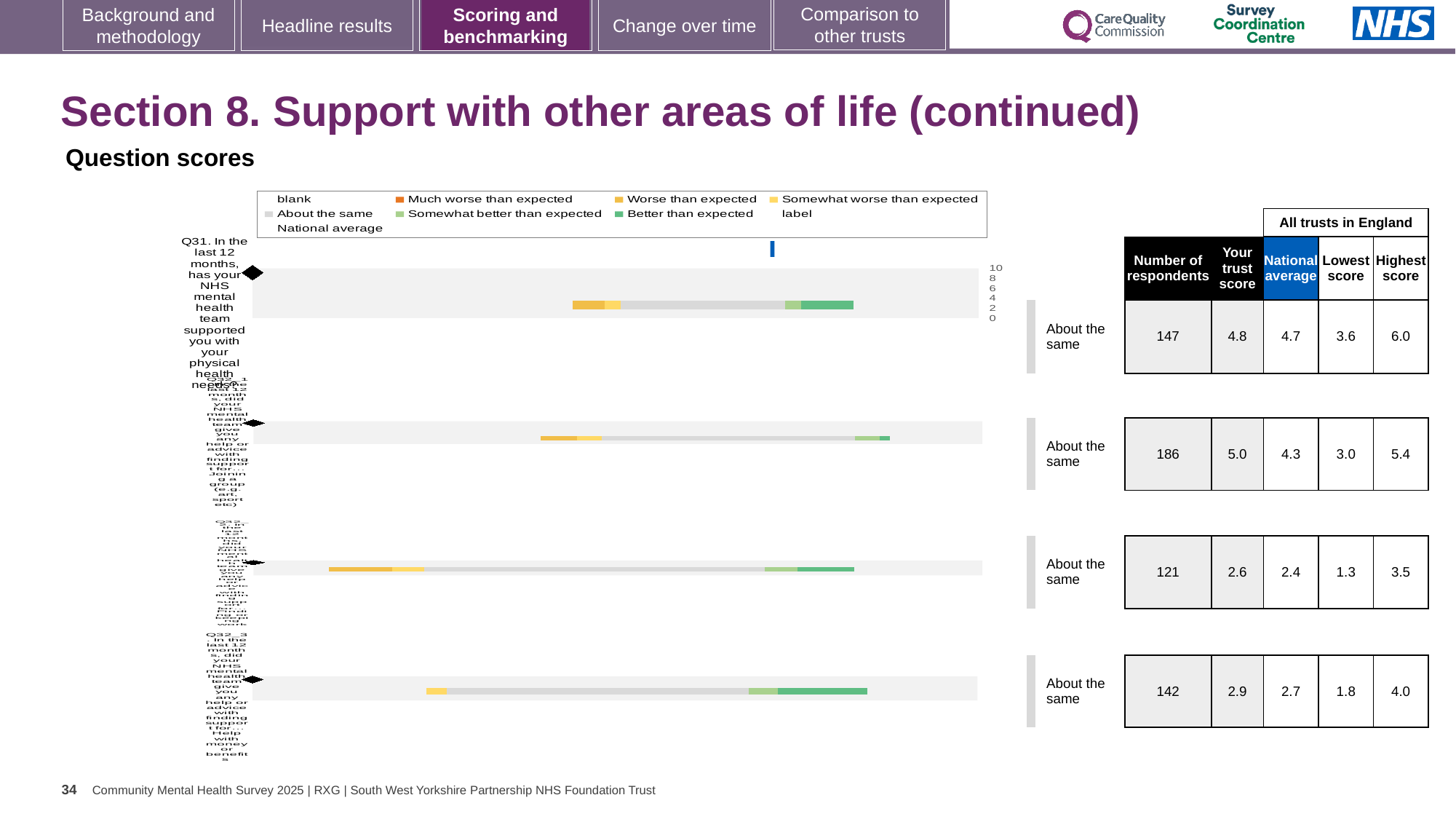
In the table, what is the number of respondents for Q31 (support with physical health needs)? 147 In the table, what is the trust score for Q31 (support with physical health needs)? 4.8 Which legend entry is shown with a grey colour? About the same For Q31, which is larger: the trust score or the national average? the trust score For Q31, what is the difference between the trust score and the national average? 0.1 In the table, what is the highest score among all trusts in England for Q31? 6.0 What kind of chart is shown on the slide? bar chart In the table, what is the national average for Q31 (support with physical health needs)? 4.7 Which row of the table has the highest number of respondents? the second row (186) Which legend entry is shown with a dark green colour? Better than expected How many question bars are plotted in the chart? 4 In the table, what is the lowest score among all trusts in England for Q31? 3.6